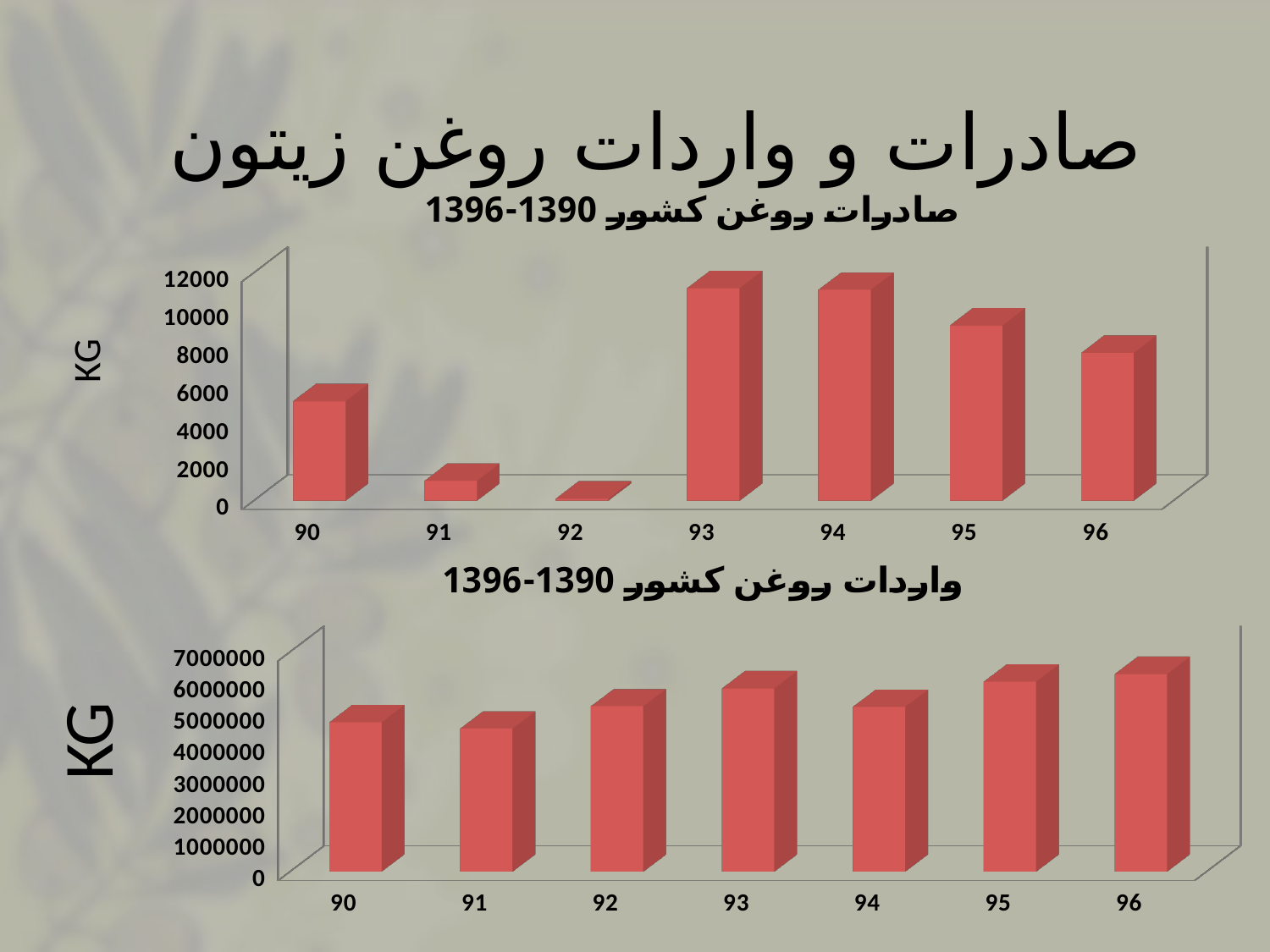
What kind of chart is the top chart (صادرات روغن کشور 1390-1396)? bar chart In the top chart (صادرات روغن کشور 1390-1396), which is larger, the value for 90 or the value for 91? 90 In the top chart (صادرات روغن کشور 1390-1396), which category has the lowest value? 92 In the top chart (صادرات روغن کشور 1390-1396), is the value for 96 greater or less than 10000? less In the bottom chart (واردات روغن کشور 1390-1396), which is larger, the value for 91 or the value for 96? 96 How many categories are shown on the x axis of the bottom chart (واردات روغن کشور 1390-1396)? 7 In the top chart (صادرات روغن کشور 1390-1396), is the value for 90 greater or less than 4000? greater How many categories are shown on the x axis of the top chart (صادرات روغن کشور 1390-1396)? 7 What unit is shown on the vertical axis label of the bottom chart (واردات روغن کشور 1390-1396)? KG In the top chart (صادرات روغن کشور 1390-1396), which is larger, the value for 93 or the value for 96? 93 In the bottom chart (واردات روغن کشور 1390-1396), is the value for 91 greater or less than 5000000? less